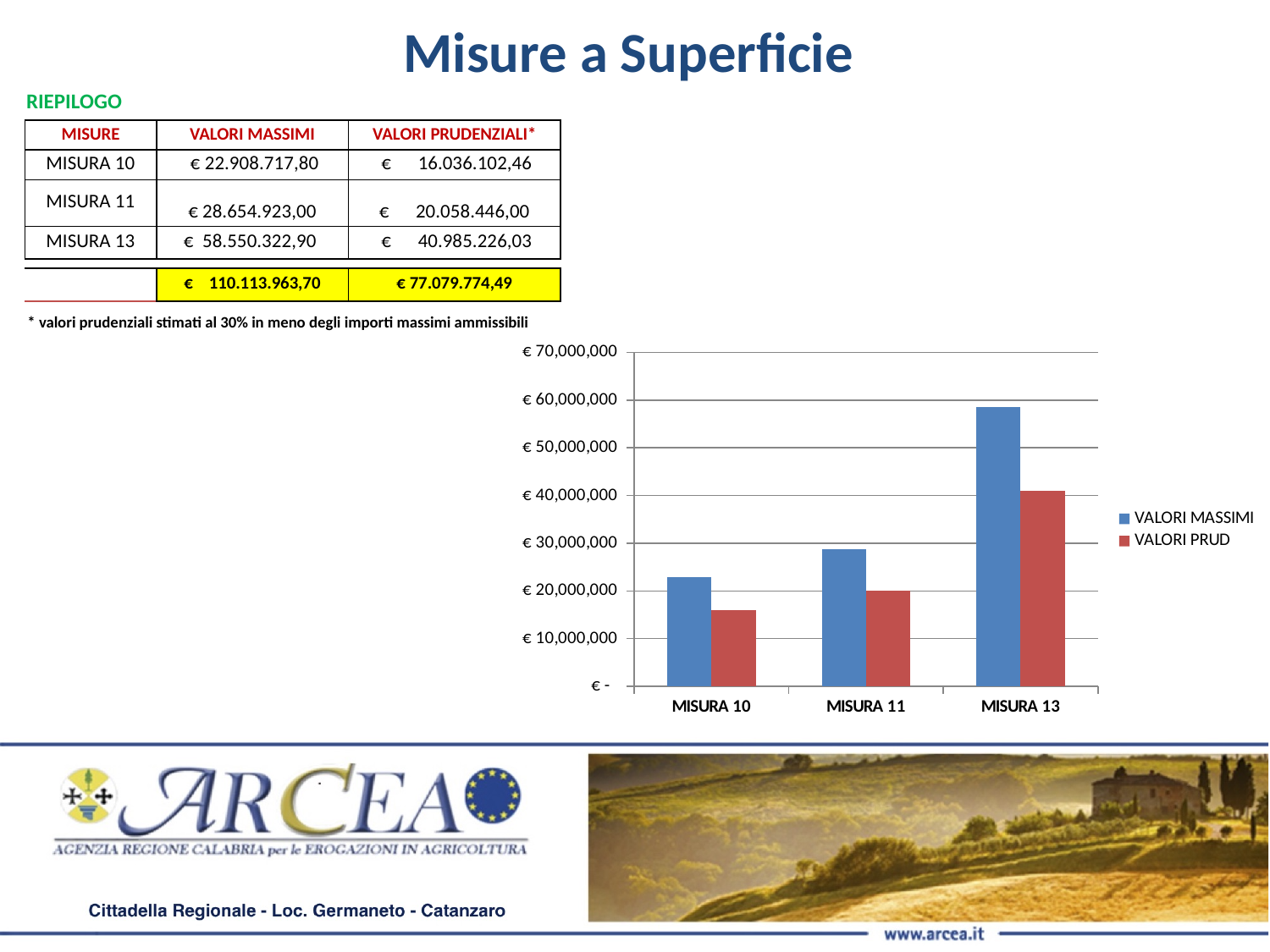
Is the VALORI MASSIMI value for MISURA 11 greater or less than € 30,000,000? less Which category has the highest VALORI MASSIMI bar in the chart? MISURA 13 Is the VALORI MASSIMI value for MISURA 13 greater or less than € 50,000,000? greater What kind of chart is shown on the slide? bar chart How many categories are shown on the x axis of the chart? 3 How many series does the chart legend list? 2 Which series in the chart legend is shown in blue? VALORI MASSIMI Do the VALORI MASSIMI bars rise or fall from MISURA 10 to MISURA 13? rise According to the table, what is the VALORI MASSIMI value for MISURA 13 plotted in the chart? € 58.550.322,90 Which is larger for MISURA 11: the VALORI MASSIMI bar or the VALORI PRUD bar? VALORI MASSIMI Is the VALORI PRUD value for MISURA 10 greater or less than € 20,000,000? less Which category has the lowest VALORI PRUD bar in the chart? MISURA 10